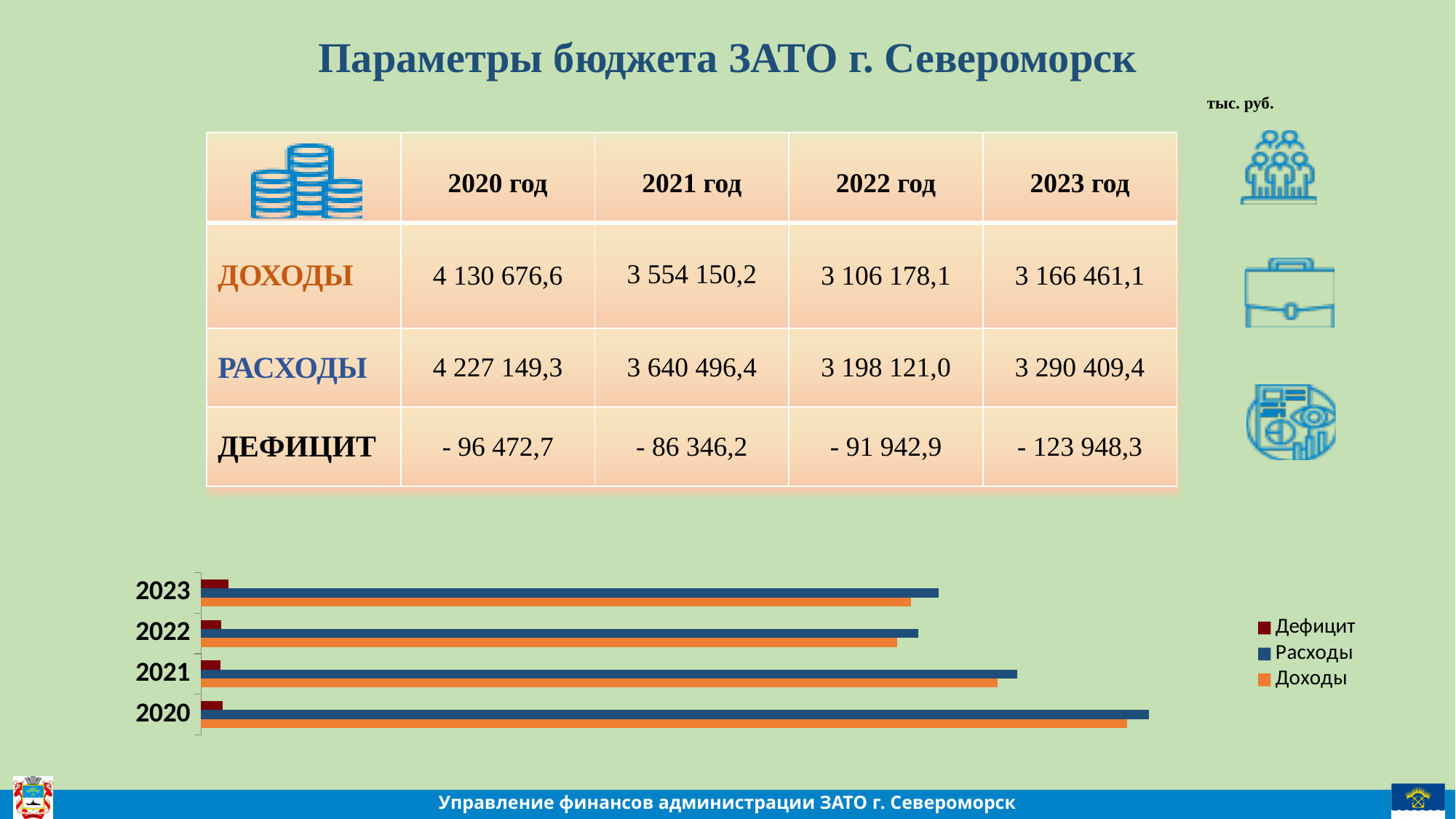
Which year has the longest Расходы bar in the chart? 2020 In 2021, which bar is longer: Расходы or Доходы? Расходы How many series does the chart legend list? 3 Which series in the chart legend is shown in orange? Доходы What is the value of Доходы for 2020 (тыс. руб.)? 4 130 676,6 What is the value of Расходы for 2023 (тыс. руб.)? 3 290 409,4 Which year has the longest Доходы bar in the chart? 2020 What kind of chart is shown at the bottom of the slide? bar chart How many years are shown as categories on the chart's vertical axis? 4 What colour is the Дефицит series in the chart legend? dark red Do the Расходы bars get longer or shorter going from 2020 to 2022? shorter By how much do Расходы exceed Доходы in 2021 (тыс. руб.)? 86 346,2